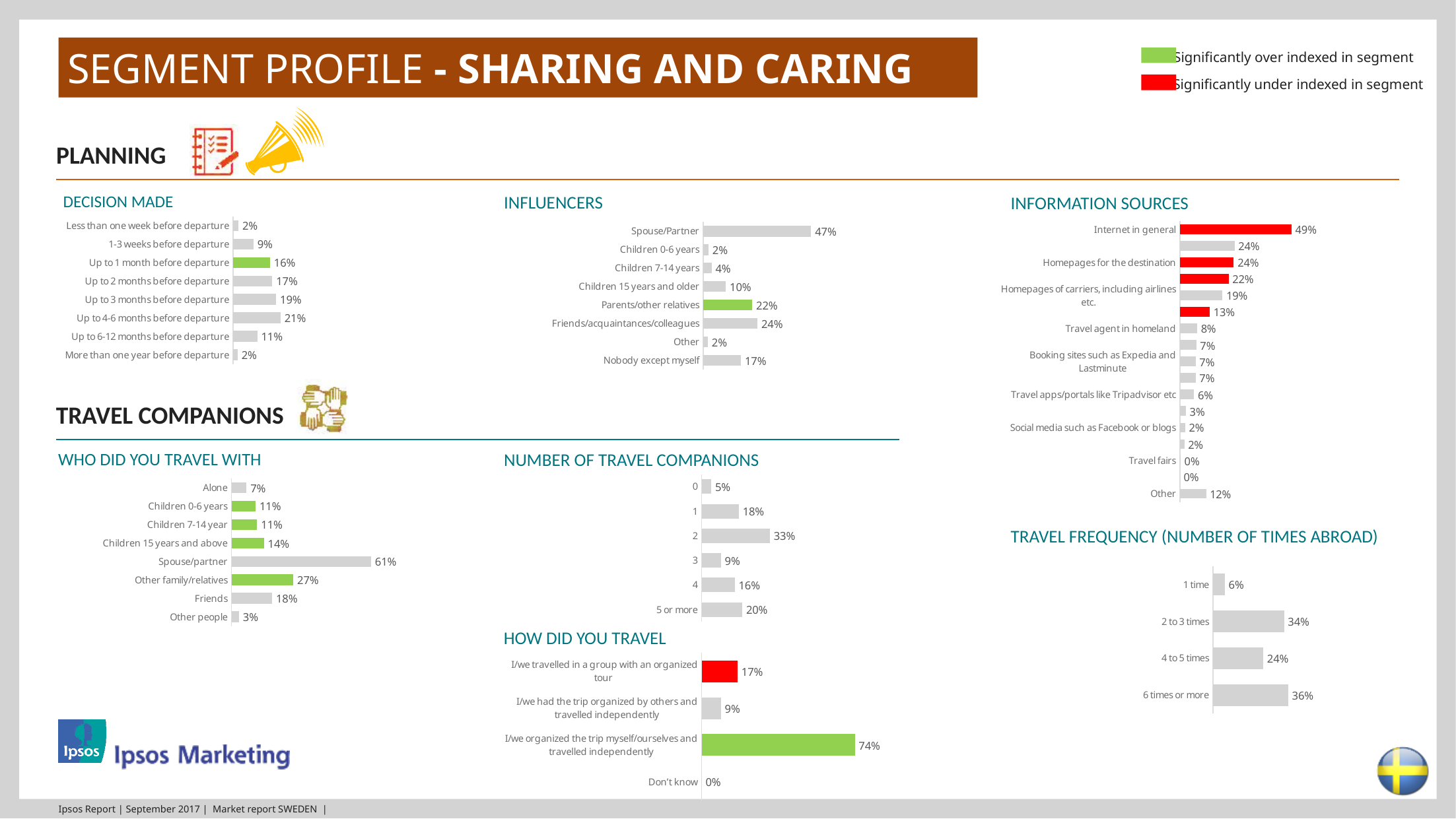
In the WHO DID YOU TRAVEL WITH chart, which category has the highest value? Spouse/partner In the INFLUENCERS chart, what is the difference between 'Friends/acquaintances/colleagues' and 'Nobody except myself'? 7% In the TRAVEL FREQUENCY (NUMBER OF TIMES ABROAD) chart, what is the difference between '6 times or more' and '2 to 3 times'? 2% What type of chart is the TRAVEL FREQUENCY (NUMBER OF TIMES ABROAD) chart? Bar chart In the NUMBER OF TRAVEL COMPANIONS chart, what is the value for '2'? 33% In the WHO DID YOU TRAVEL WITH chart, which is larger, 'Other family/relatives' or 'Friends'? Other family/relatives In the INFLUENCERS chart, which category has the highest value? Spouse/Partner In the HOW DID YOU TRAVEL chart, what is the value for 'I/we organized the trip myself/ourselves and travelled independently'? 74% In the DECISION MADE chart, what is the value for 'Up to 4-6 months before departure'? 21% In the DECISION MADE chart, how many categories are shown? 8 In the NUMBER OF TRAVEL COMPANIONS chart, which category has the lowest value? 0 In the INFORMATION SOURCES chart, what is the value for 'Internet in general'? 49%